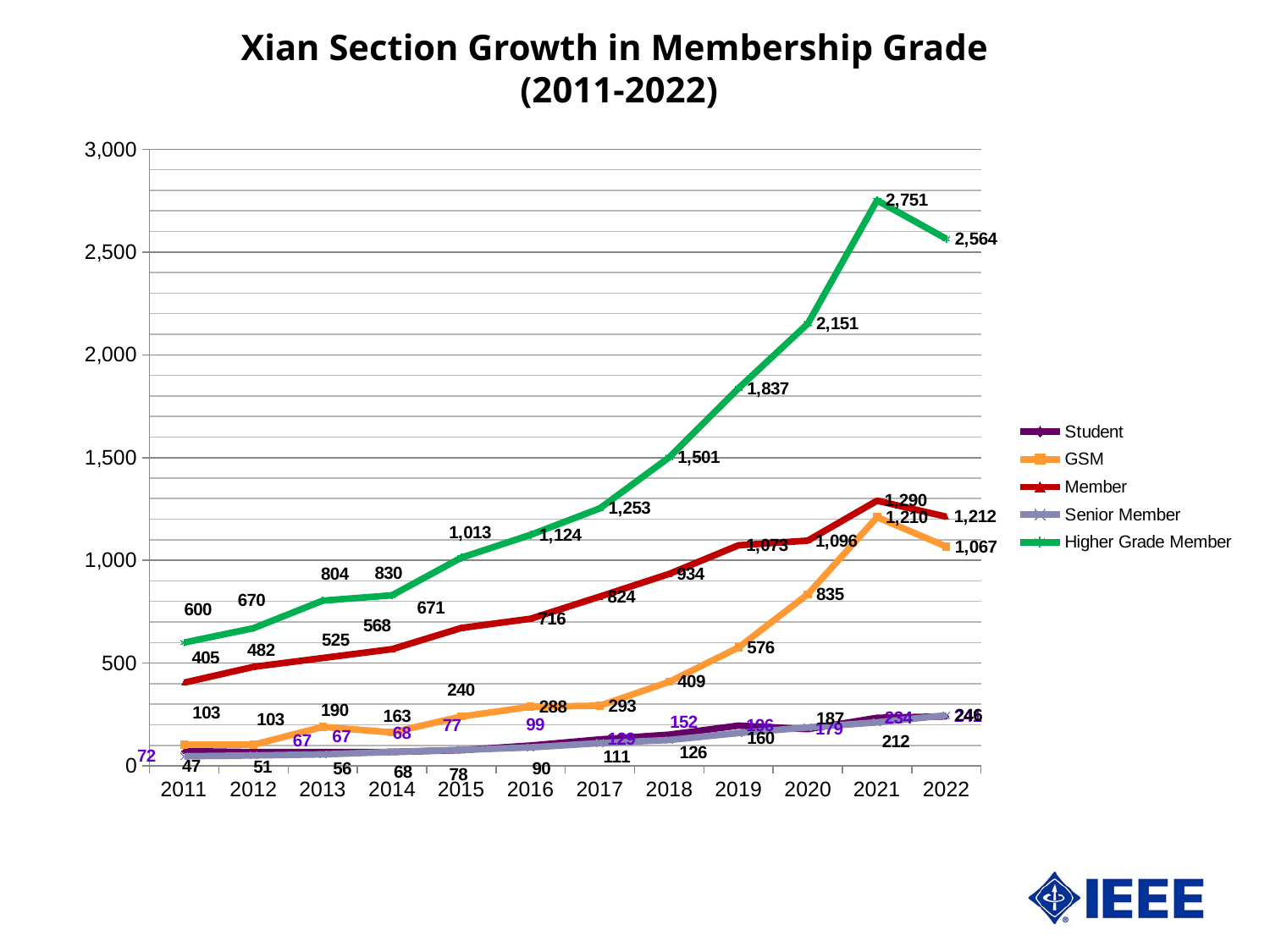
Does the Higher Grade Member series rise or fall from 2011 to 2021? rise In which year does the Higher Grade Member series reach its highest value? 2021 What is the Higher Grade Member value in 2021? 2,751 What is the Member value in 2019? 1,073 What kind of chart is shown on the slide? line chart How many years are plotted along the x axis? 12 In 2021, which is larger: the GSM value or the Member value? Member What is the Student value in 2016? 99 How many series does the legend list? 5 By how much did the Higher Grade Member value fall from 2021 to 2022? 187 What is the GSM value in 2020? 835 What is the Senior Member value in 2020? 187